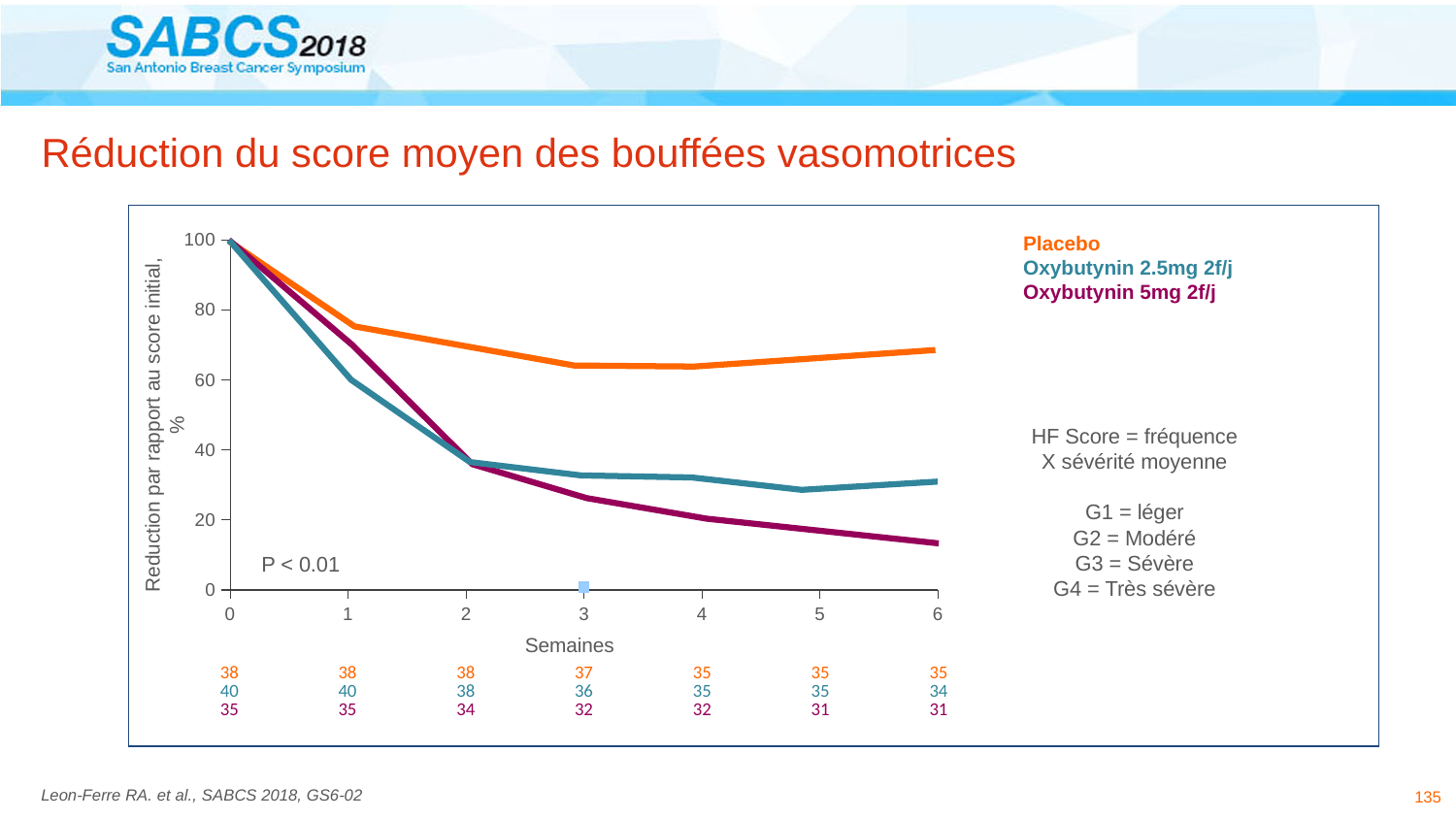
Is the value for Placebo at week 6 greater or less than 60? greater What is the title of the chart? Réduction du score moyen des bouffées vasomotrices What is the value for all three series at week 0? 100 Is the value for Oxybutynin 5mg 2f/j at week 3 greater or less than 40? less What kind of chart is shown on the slide? line chart Which series has the highest value at week 6? Placebo Which series has the lowest value at week 6? Oxybutynin 5mg 2f/j What is the label of the x axis? Semaines At week 1, which is larger: the value for Placebo or the value for Oxybutynin 2.5mg 2f/j? Placebo How many series does the legend list? 3 Does the Oxybutynin 5mg 2f/j line rise or fall from week 0 to week 6? fall At week 4, which is larger: the value for Oxybutynin 2.5mg 2f/j or the value for Oxybutynin 5mg 2f/j? Oxybutynin 2.5mg 2f/j